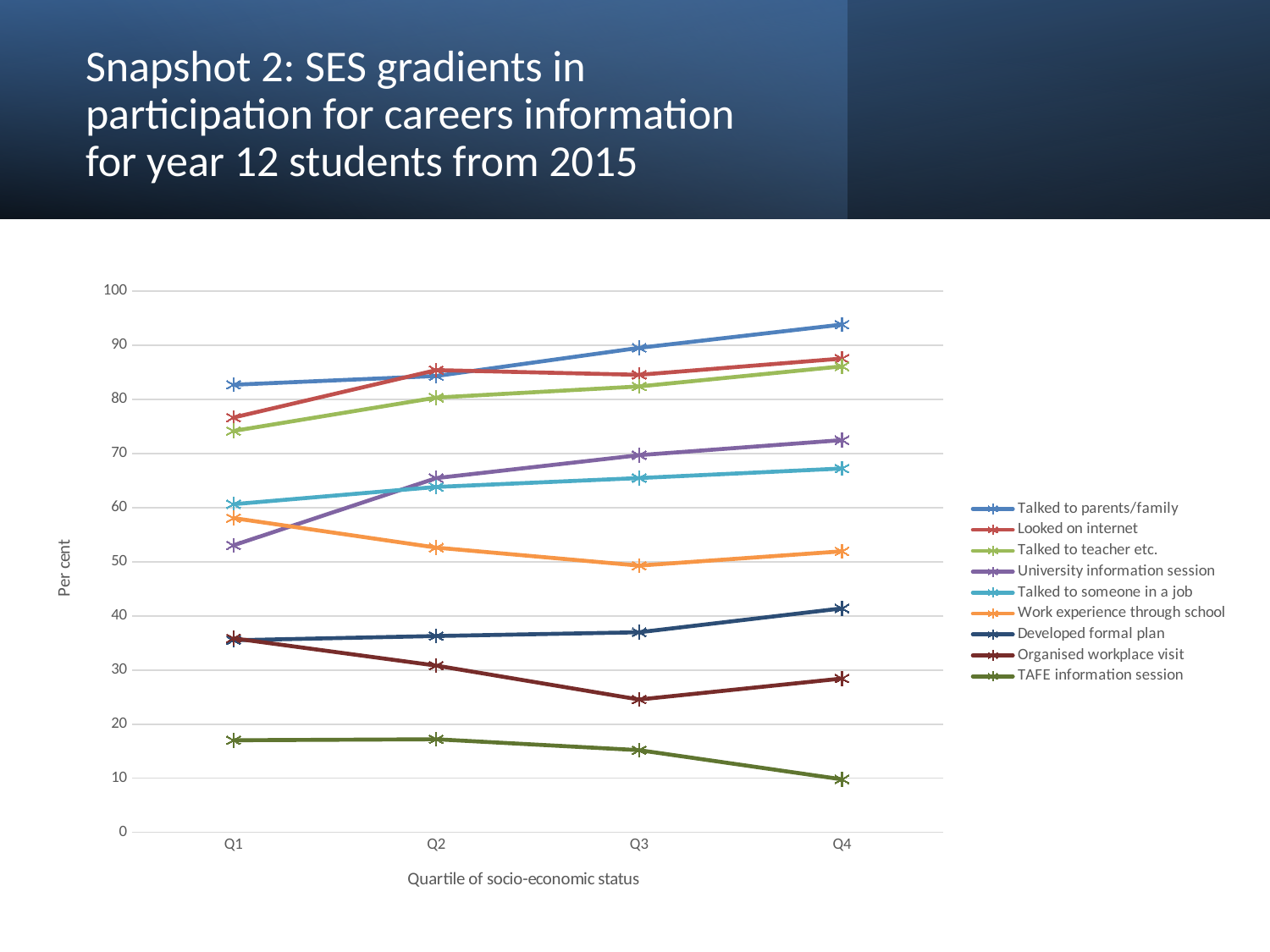
Does the Talked to parents/family line rise or fall from Q1 to Q4? Rise Is the value for University information session at Q1 greater or less than 60? less What is the label on the x axis of the chart? Quartile of socio-economic status Is the value for Talked to parents/family at Q4 greater or less than 90? greater Does the TAFE information session line rise or fall from Q1 to Q4? Fall Is the value for Organised workplace visit at Q3 greater or less than 30? less What kind of chart is shown on the slide? Line chart How many quartile categories are shown on the x axis? 4 Which series has the highest value at Q4? Talked to parents/family At Q1, which is larger: University information session or Talked to someone in a job? Talked to someone in a job How many series does the legend list? 9 Which series has the lowest value at Q4? TAFE information session